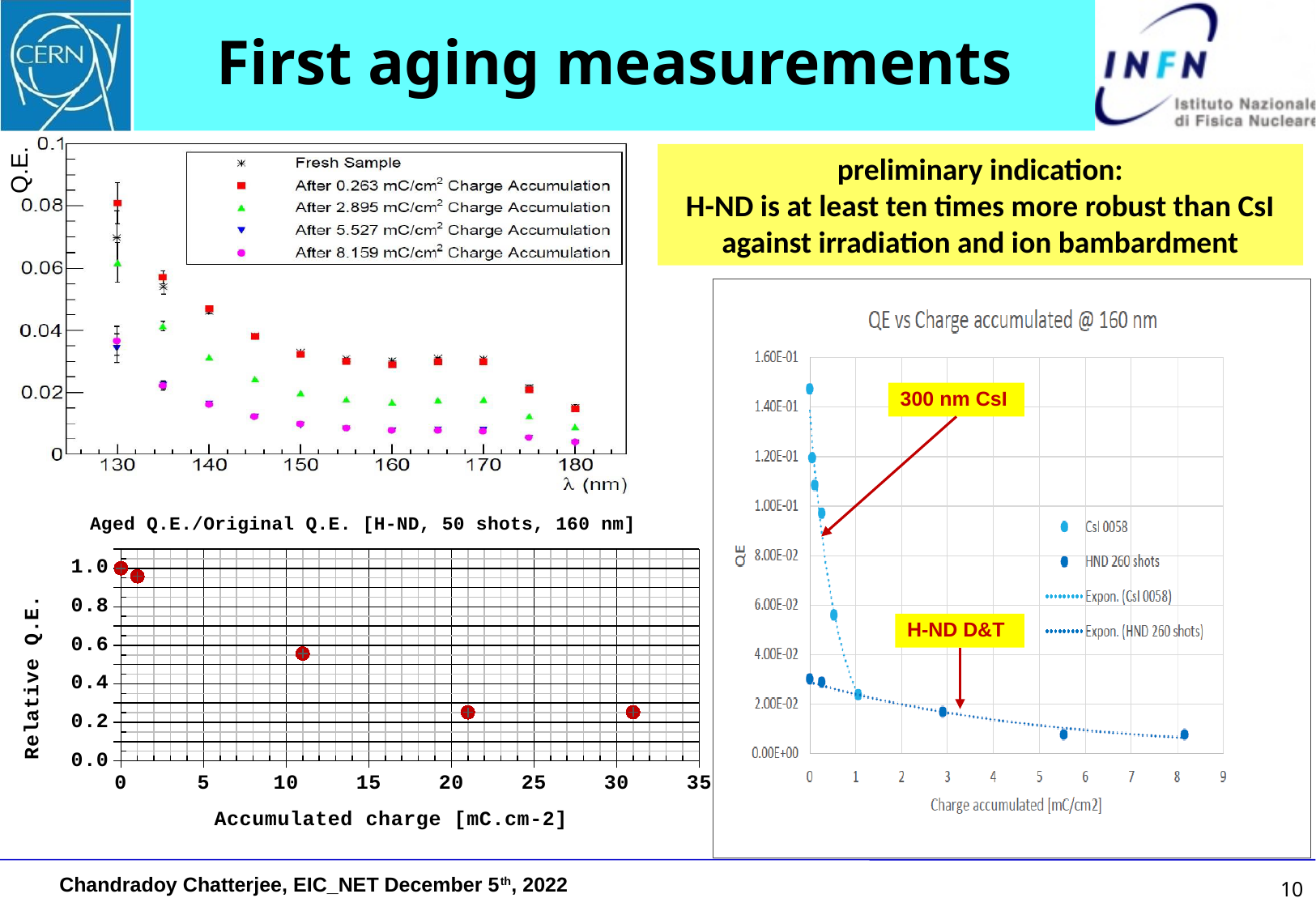
On the top-left chart of Q.E. versus wavelength, how many series does the legend list? 5 On the top-left chart of Q.E. versus wavelength, at 130 nm, which series has the larger value: 'After 0.263 mC/cm2 Charge Accumulation' or 'After 8.159 mC/cm2 Charge Accumulation'? After 0.263 mC/cm2 Charge Accumulation On the right chart 'QE vs Charge accumulated @ 160 nm', at a charge of 0 mC/cm2, which series has the larger QE: CsI 0058 or HND 260 shots? CsI 0058 On the right chart 'QE vs Charge accumulated @ 160 nm', how many entries does the legend list? 4 What is the title of the bottom-left chart? Aged Q.E./Original Q.E. [H-ND, 50 shots, 160 nm] On the bottom-left chart 'Aged Q.E./Original Q.E.', does the relative Q.E. rise or fall as the accumulated charge increases? fall On the top-left chart of Q.E. versus wavelength, what kind of chart is it? scatter plot What is the title of the chart on the right side of the slide? QE vs Charge accumulated @ 160 nm On the bottom-left chart 'Aged Q.E./Original Q.E.', is the relative Q.E. at about 31 mC.cm-2 greater or less than 0.4? less On the top-left chart of Q.E. versus wavelength, do the Q.E. values generally rise or fall as the wavelength increases from 130 nm to 180 nm? fall On the top-left chart of Q.E. versus wavelength, is the Fresh Sample value at 130 nm greater or less than 0.06? greater On the bottom-left chart 'Aged Q.E./Original Q.E.', how many data points are plotted? 5